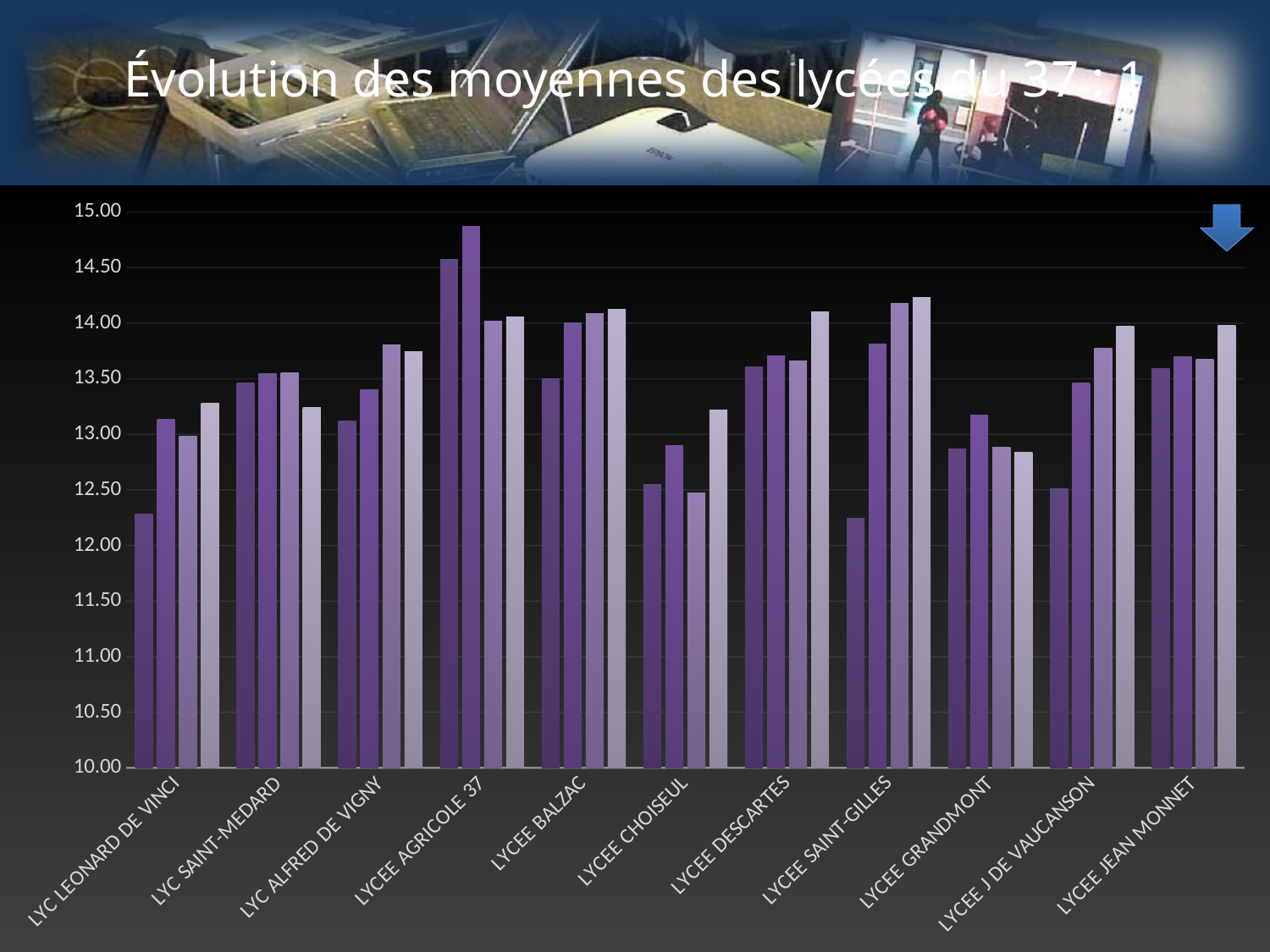
How many lycées (categories) are shown on the x axis? 11 Is the value of the leftmost bar for LYC LEONARD DE VINCI greater or less than 12.50? less Do the four bars for LYCEE SAINT-GILLES rise or fall from left to right? rise What is the title of the slide's chart? Évolution des moyennes des lycées du 37 : 1 Is the value of the leftmost bar for LYCEE SAINT-GILLES greater or less than 12.50? less Which is larger: the leftmost bar for LYCEE DESCARTES or the leftmost bar for LYCEE SAINT-GILLES? LYCEE DESCARTES Is the value of the second bar for LYCEE AGRICOLE 37 greater or less than 14.50? greater What kind of chart is shown on the slide? bar chart What is the highest value shown on the y axis? 15.00 Which lycée has the tallest bar in the chart? LYCEE AGRICOLE 37 How many bars are plotted for each lycée? 4